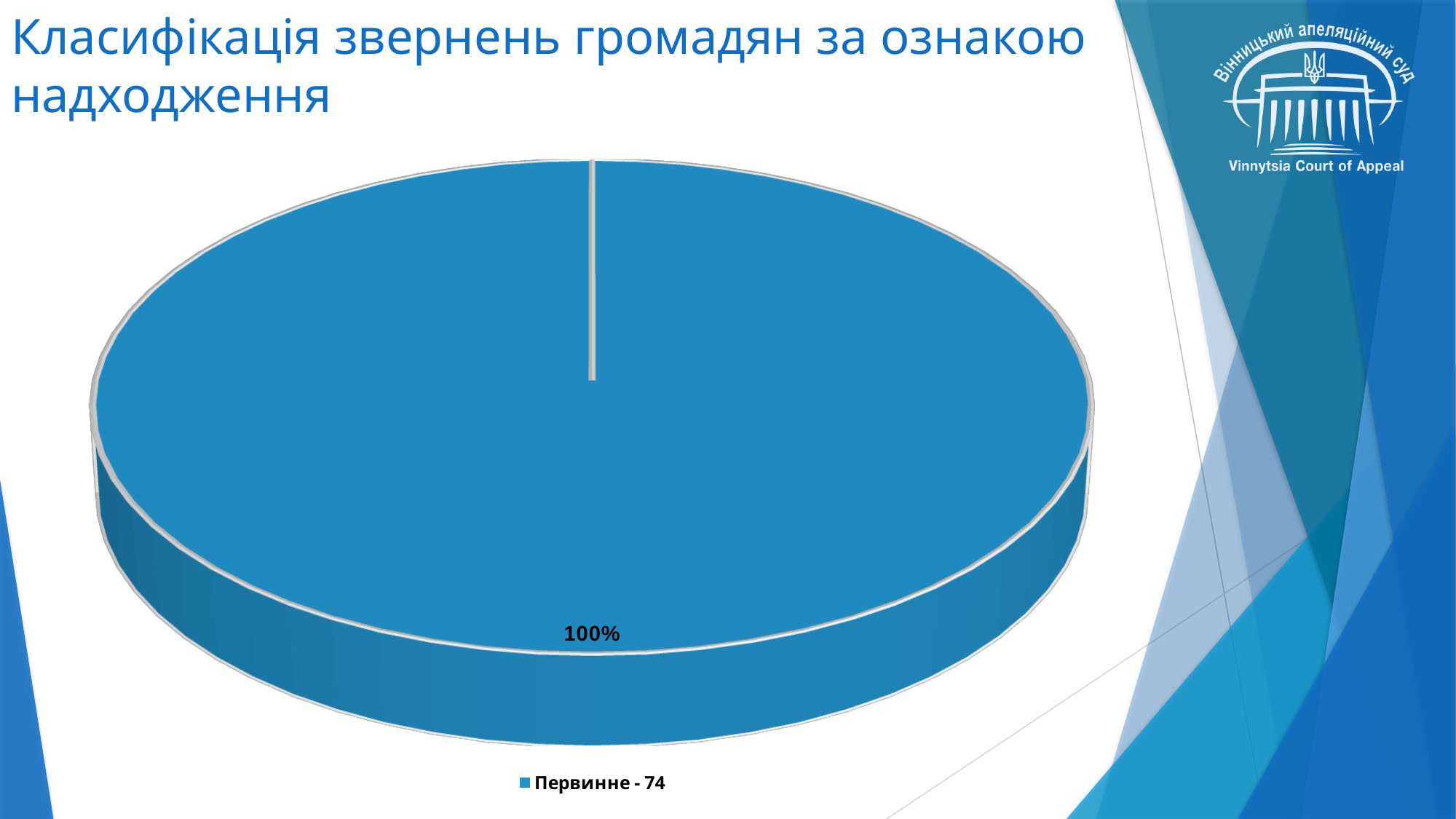
What kind of chart is shown on the slide? pie chart What percentage label is printed on the pie chart? 100% What is the legend entry shown below the pie chart? Первинне - 74 What number is given for the category "Первинне" in the legend? 74 What is the title of the slide containing the pie chart? Класифікація звернень громадян за ознакою надходження How many slices does the pie chart have? 1 How many entries does the legend list? 1 What share of the pie does the slice labelled "Первинне - 74" represent? 100%